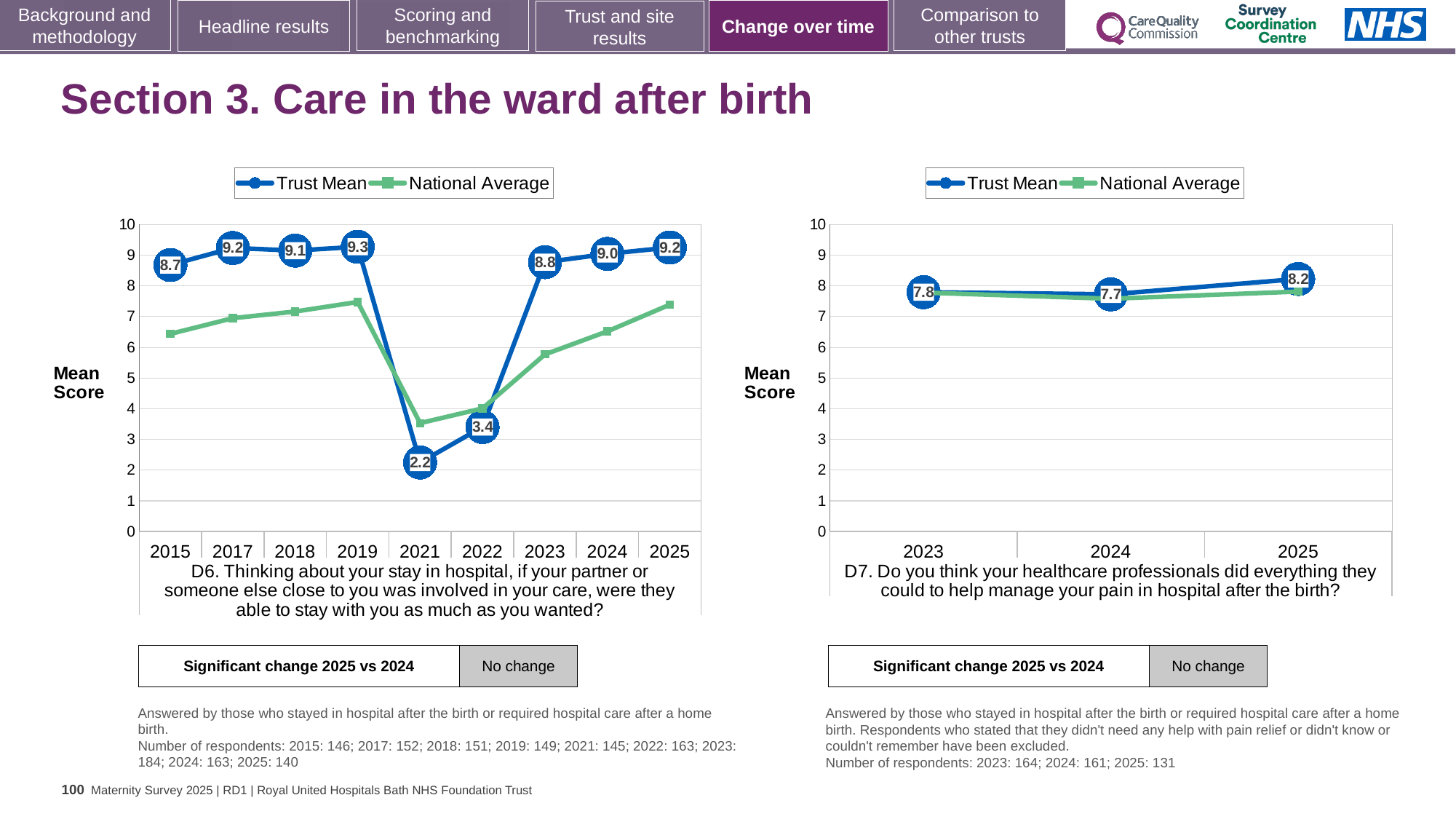
In the right chart (D7), what is the Trust Mean for 2025? 8.2 In the right chart (D7), what is the difference between the Trust Mean in 2025 and 2024? 0.5 In the left chart (D6), how many years are shown on the x axis? 9 In the left chart (D6), what is the Trust Mean for 2019? 9.3 In the left chart (D6), what is the difference between the Trust Mean in 2022 and 2021? 1.2 What kind of chart is the left chart (D6)? Line chart In the left chart (D6), which year has the highest Trust Mean? 2019 In the left chart (D6), what is the Trust Mean for 2021? 2.2 How many series does the legend of the right chart (D7) list? 2 In the right chart (D7), which year has the lowest Trust Mean? 2024 In the left chart (D6), which year has the lowest Trust Mean? 2021 In the left chart (D6), is the National Average for 2015 greater or less than 7? less